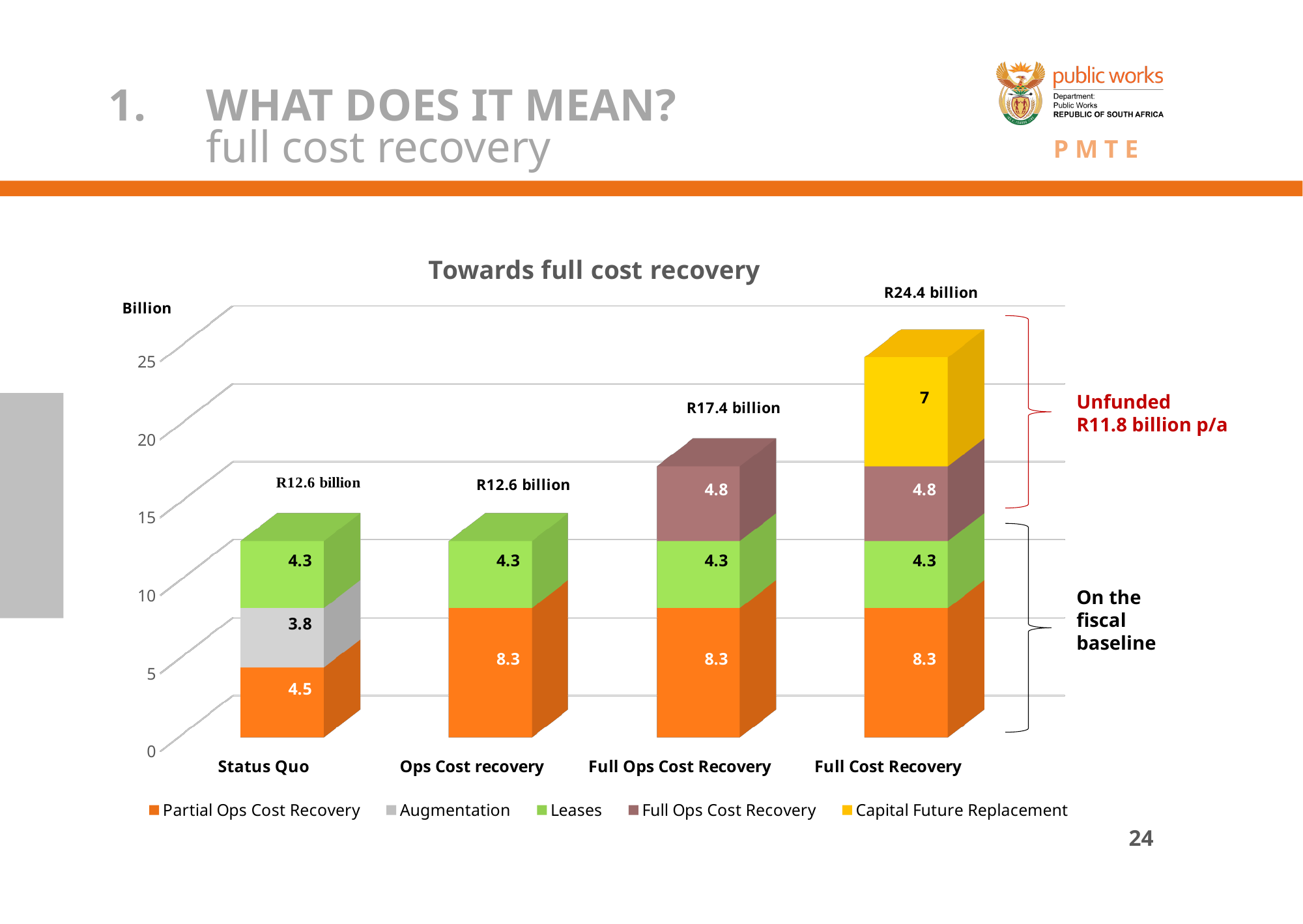
How many categories are shown on the x axis? 4 Do the bar totals rise or fall from Status Quo to Full Cost Recovery? Rise How many series does the legend list? 5 Which is larger: the Full Ops Cost Recovery segment or the Leases segment in the Full Cost Recovery bar? Full Ops Cost Recovery What is the total labelled above the Full Ops Cost Recovery bar? R17.4 billion What kind of chart is shown on the slide? Stacked bar chart What is the title of the chart? Towards full cost recovery Which category has the highest total? Full Cost Recovery What is the difference between the Partial Ops Cost Recovery value for Ops Cost recovery and for Status Quo? 3.8 What is the value of Augmentation for Status Quo? 3.8 What is the value of Capital Future Replacement for Full Cost Recovery? 7 What is the value of Partial Ops Cost Recovery for Status Quo? 4.5